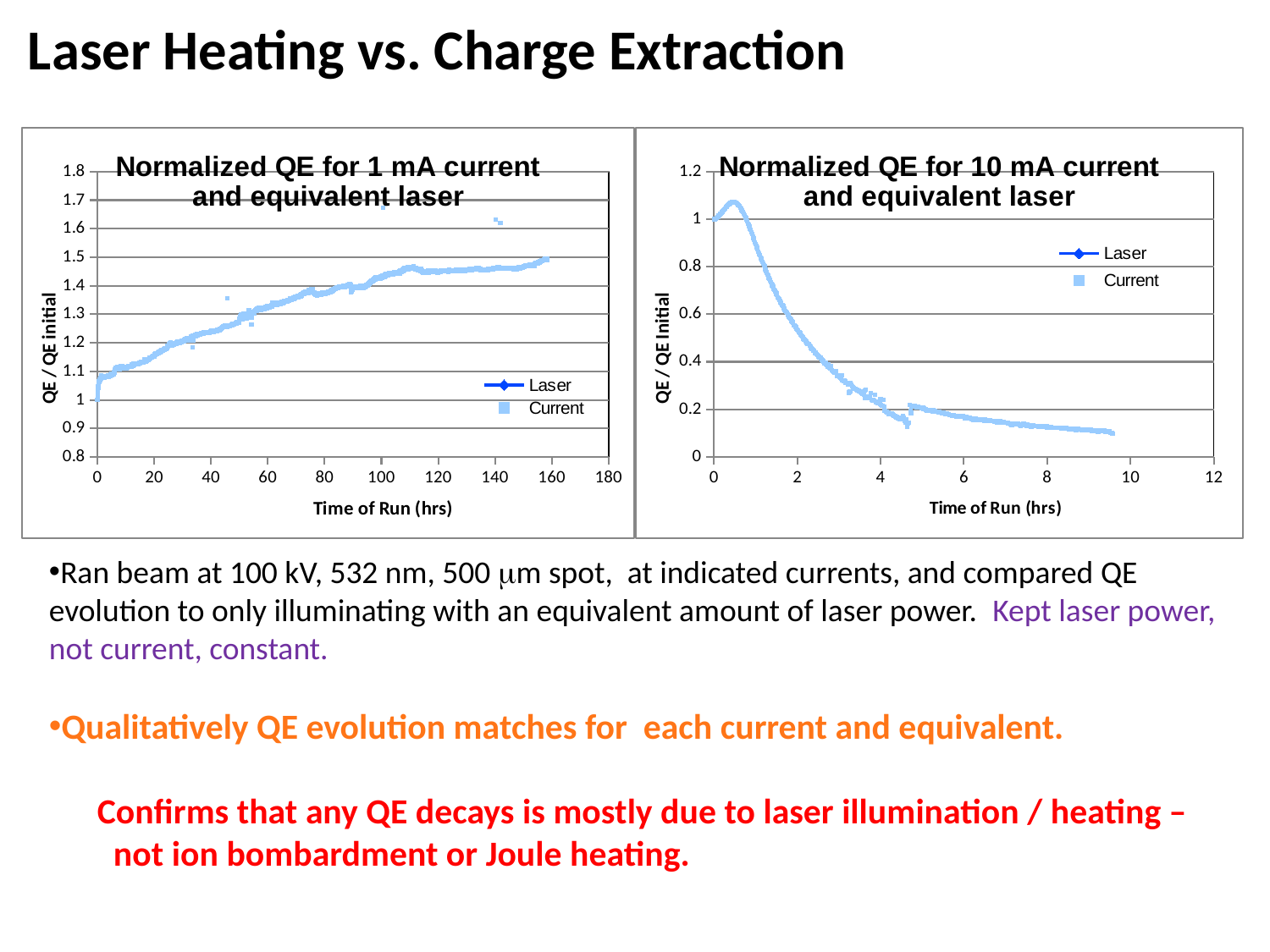
In the 'Normalized QE for 10 mA current and equivalent laser' chart, is the value at 8 hrs greater or less than 0.2? less In the 'Normalized QE for 10 mA current and equivalent laser' chart, is the value at 1 hr greater or less than 0.6? greater In the 'Normalized QE for 1 mA current and equivalent laser' chart, do the values rise or fall as time of run increases? Rise In the 'Normalized QE for 10 mA current and equivalent laser' chart, is the value at 4 hrs greater or less than 0.4? less How many series does the legend list in the 'Normalized QE for 1 mA current and equivalent laser' chart? 2 What is the x-axis label of the 'Normalized QE for 1 mA current and equivalent laser' chart? Time of Run (hrs) What are the two series named in the legend of the 'Normalized QE for 10 mA current and equivalent laser' chart? Laser and Current What kind of chart is the 'Normalized QE for 1 mA current and equivalent laser' chart? Scatter (line) chart In the 'Normalized QE for 10 mA current and equivalent laser' chart, do the values rise or fall overall as time of run increases? Fall